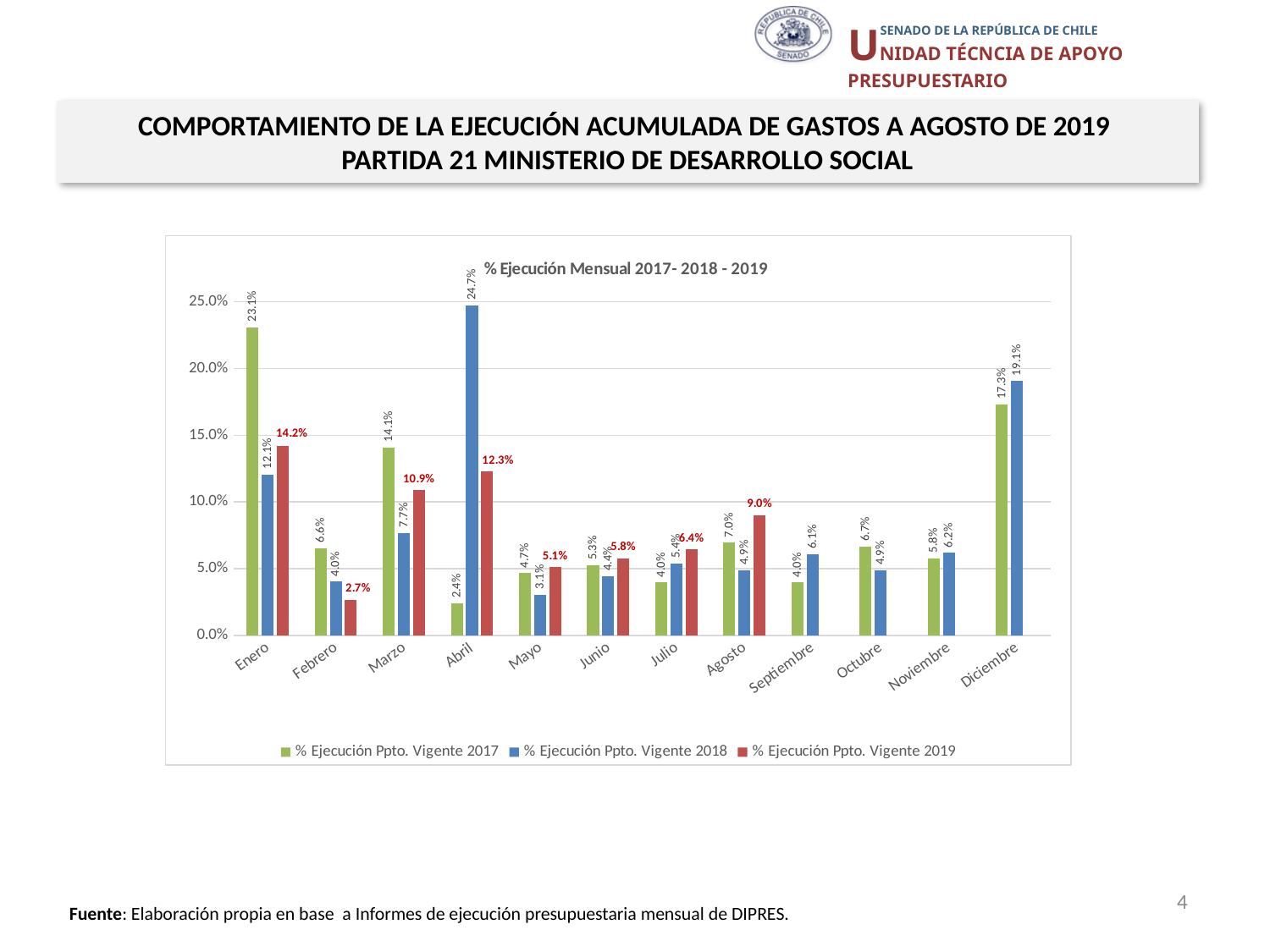
What is the value for % Ejecución Ppto. Vigente 2017 in Diciembre? 17.3% What is the value for % Ejecución Ppto. Vigente 2018 in Abril? 24.7% How many months are shown on the x axis? 12 Which month has the highest value for % Ejecución Ppto. Vigente 2017? Enero What is the value for % Ejecución Ppto. Vigente 2019 in Enero? 14.2% Is the value for % Ejecución Ppto. Vigente 2018 in Enero greater or less than 10.0%? greater What kind of chart is shown on the slide? Bar chart What is the difference between the 2019 and 2018 values in Marzo? 3.2% How many series does the legend list? 3 Which is larger in Agosto: the 2017 value or the 2019 value? 2019 value (9.0%) What is the title of the chart? % Ejecución Mensual 2017- 2018 - 2019 Which month has the lowest value for % Ejecución Ppto. Vigente 2019? Febrero